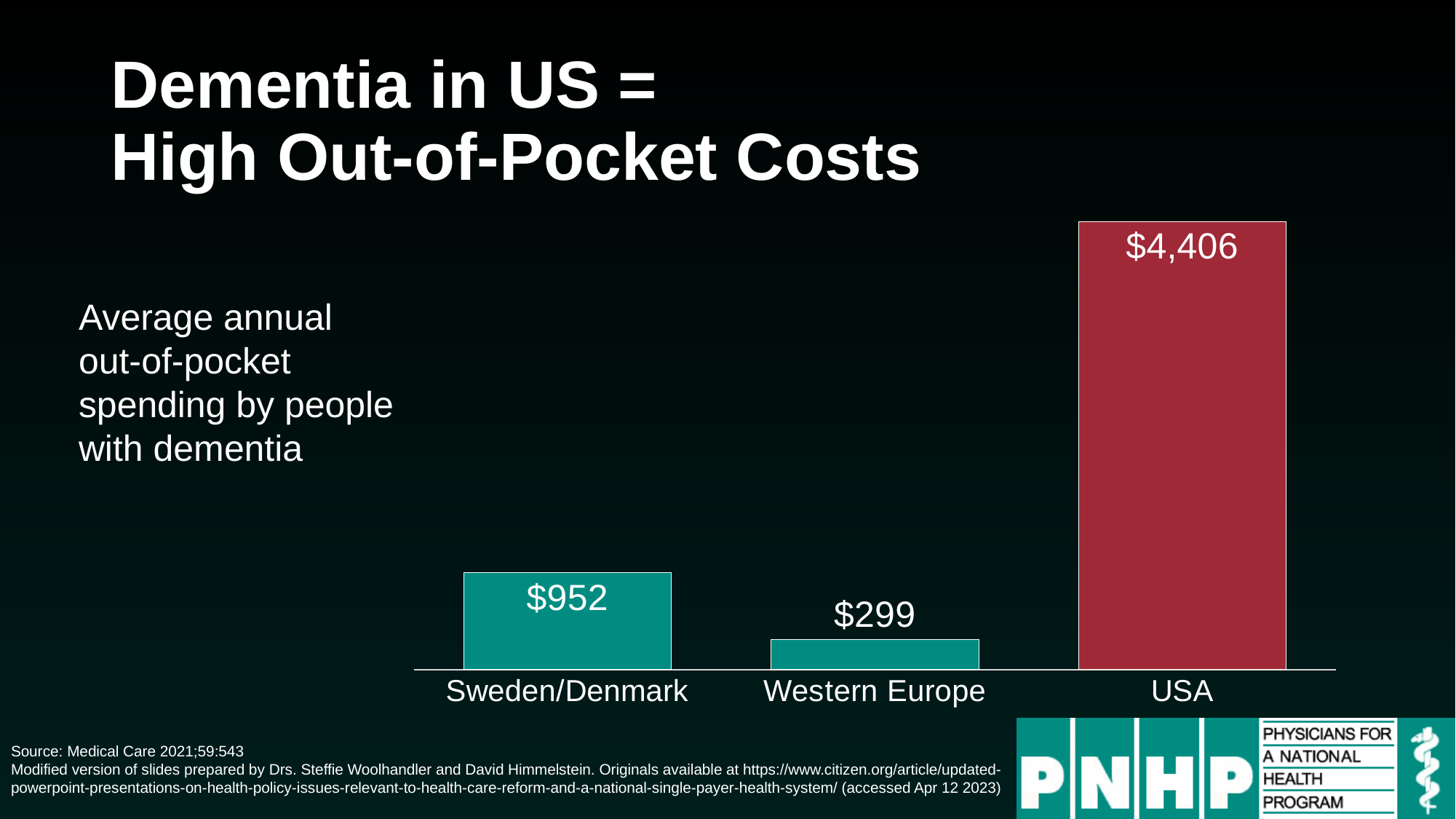
How many categories are shown in the chart? 3 What is the average annual out-of-pocket spending for people with dementia in the USA? $4,406 What colour is the bar for the USA? Red What kind of chart is shown on the slide? Bar chart What is the title of the slide? Dementia in US = High Out-of-Pocket Costs What is the value shown for Sweden/Denmark? $952 What is the difference between the Sweden/Denmark value and the Western Europe value? $653 What is the difference between the USA value and the Sweden/Denmark value? $3,454 Which category has the lowest out-of-pocket spending? Western Europe Which category has the highest out-of-pocket spending? USA What is the value shown for Western Europe? $299 Which is larger, the value for Sweden/Denmark or the value for Western Europe? Sweden/Denmark